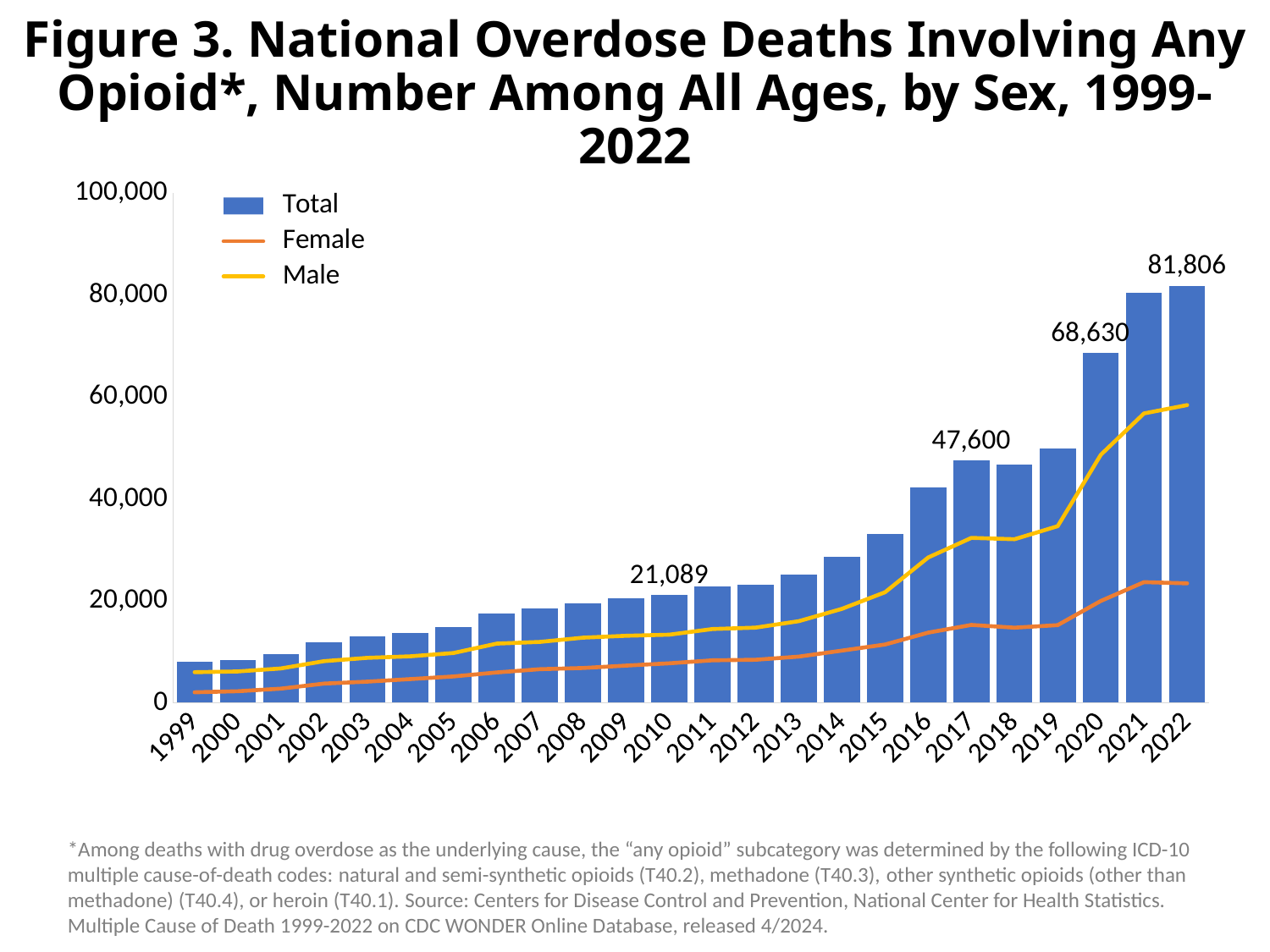
How many years are shown on the x axis of the chart? 24 How many series does the legend list? 3 Is the total number of opioid overdose deaths in 2019 greater or less than 60,000? less Is the total number of opioid overdose deaths in 2016 greater or less than 40,000? greater What is the total number of overdose deaths involving any opioid in 2020? 68,630 What is the total number of overdose deaths involving any opioid in 2022? 81,806 What is the total number of overdose deaths involving any opioid in 2017? 47,600 Which year has the lowest total number of opioid overdose deaths? 1999 By how much did the total number of opioid overdose deaths increase from 2020 to 2022? 13,176 Which year has the highest total number of opioid overdose deaths? 2022 What is the total number of overdose deaths involving any opioid in 2010? 21,089 Overall, do the total opioid overdose deaths rise or fall from 1999 to 2022? rise